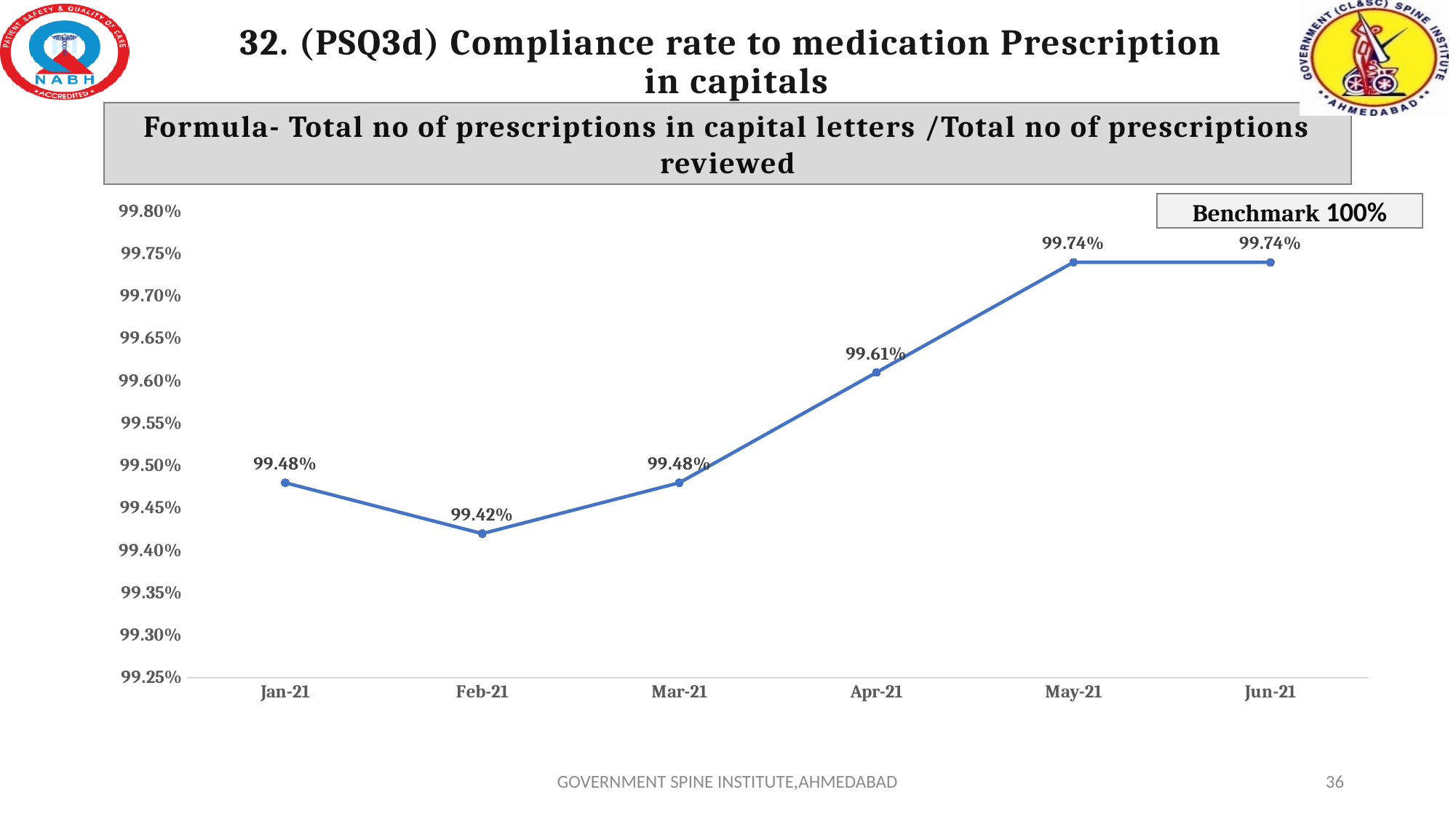
What benchmark value is shown on the slide? 100% What is the compliance rate for Jan-21? 99.48% What kind of chart is shown on the slide? Line chart What is the compliance rate for Apr-21? 99.61% Which is larger, the compliance rate for Mar-21 or Apr-21? Apr-21 What is the difference between the compliance rates for May-21 and Feb-21? 0.32% How many months are plotted on the chart? 6 What is the compliance rate for Feb-21? 99.42% Does the compliance rate rise or fall from Feb-21 to May-21? Rise Which month has the lowest compliance rate? Feb-21 What is the highest compliance rate shown on the chart? 99.74% What is the difference between the compliance rates for Apr-21 and Mar-21? 0.13%